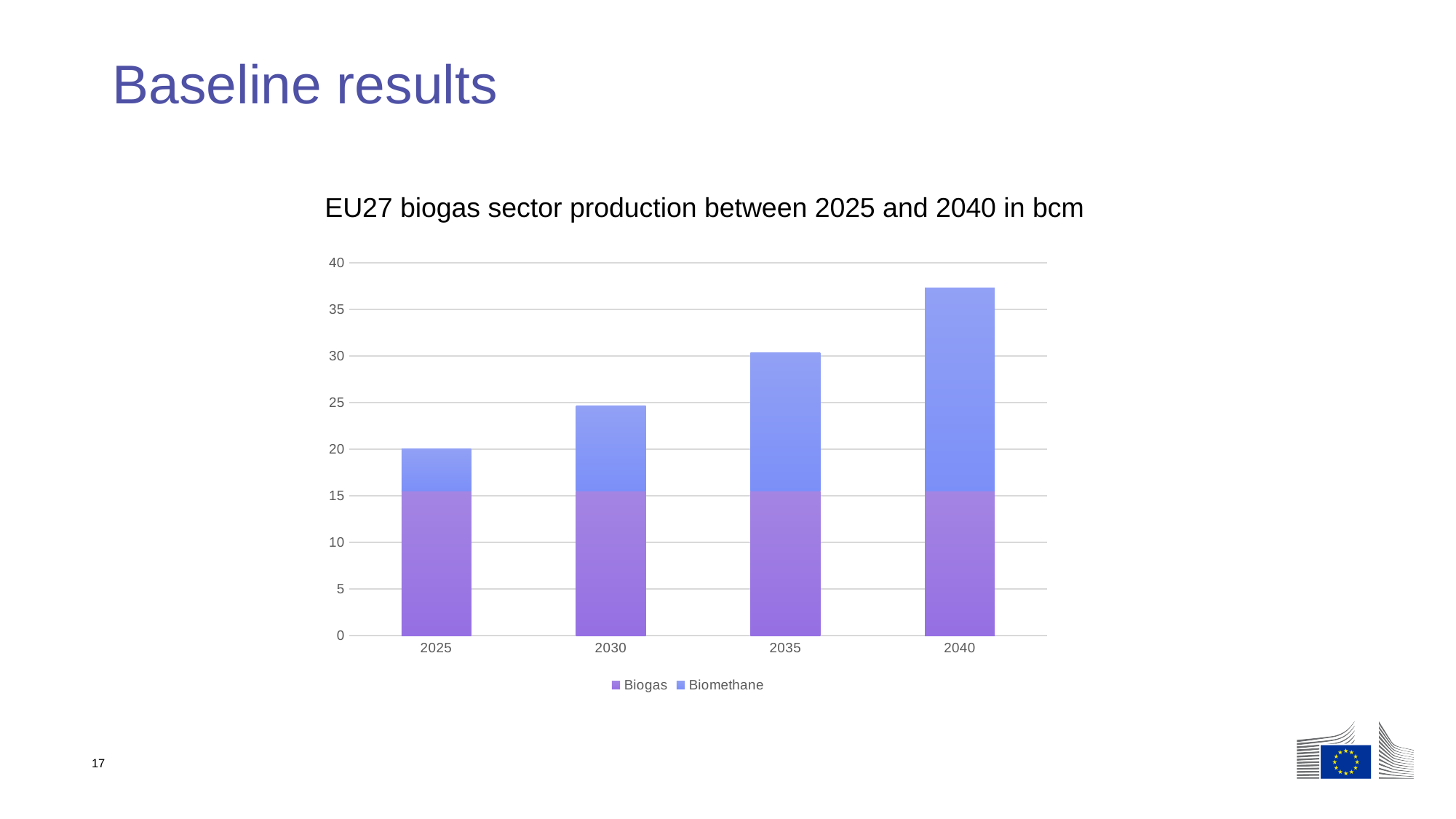
Does total production rise or fall from 2025 to 2040? Rises Is the total production for 2035 greater or less than 35? less Is the total production for 2040 greater or less than 35? greater What kind of chart is shown on the slide? Stacked bar chart Which series are listed in the legend? Biogas and Biomethane How many years are shown on the x axis? 4 Which year has the lowest total production? 2025 What is the title of the chart? EU27 biogas sector production between 2025 and 2040 in bcm Which is larger, the Biomethane value for 2040 or the Biomethane value for 2025? 2040 Is the total production for 2030 greater or less than 20? greater How many series does the legend list? 2 Which year has the highest total production? 2040